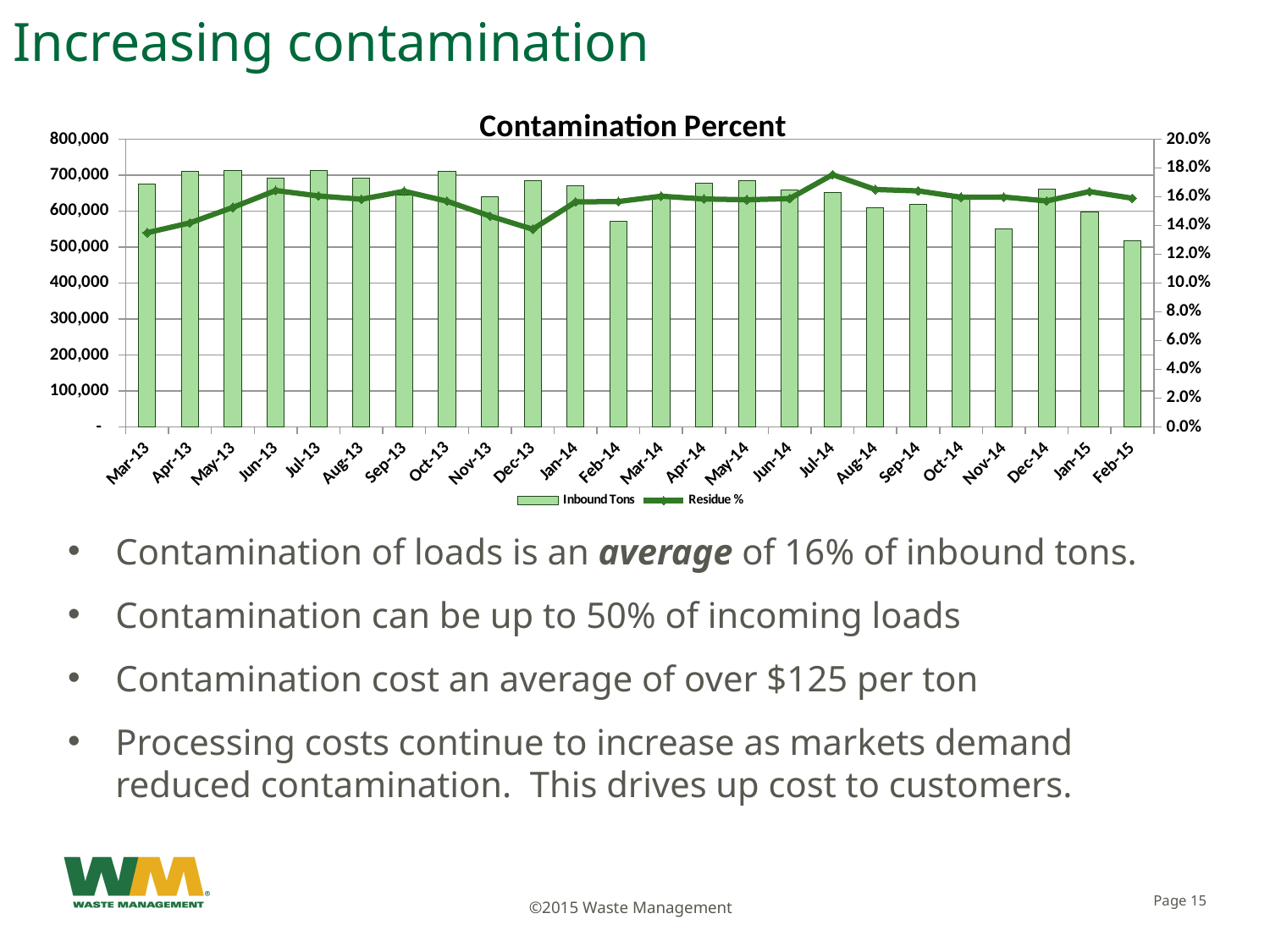
Which month has the lowest Inbound Tons bar? Feb-15 In which month does the Residue % line reach its highest point? Jul-14 Which month has the larger Inbound Tons bar, Mar-13 or Feb-15? Mar-13 How many months are plotted along the x axis? 24 Is the Inbound Tons value for Mar-13 greater or less than 600,000? greater Is the Inbound Tons value for Feb-15 greater or less than 600,000? less What kind of chart is shown on the slide? A combined bar and line chart What is the title of the chart? Contamination Percent How many series does the chart legend list? 2 Does the Residue % line generally rise or fall from Mar-13 to Feb-15? rise What are the two series named in the legend? Inbound Tons and Residue % Is the Residue % value for Jul-14 greater or less than 16.0%? greater